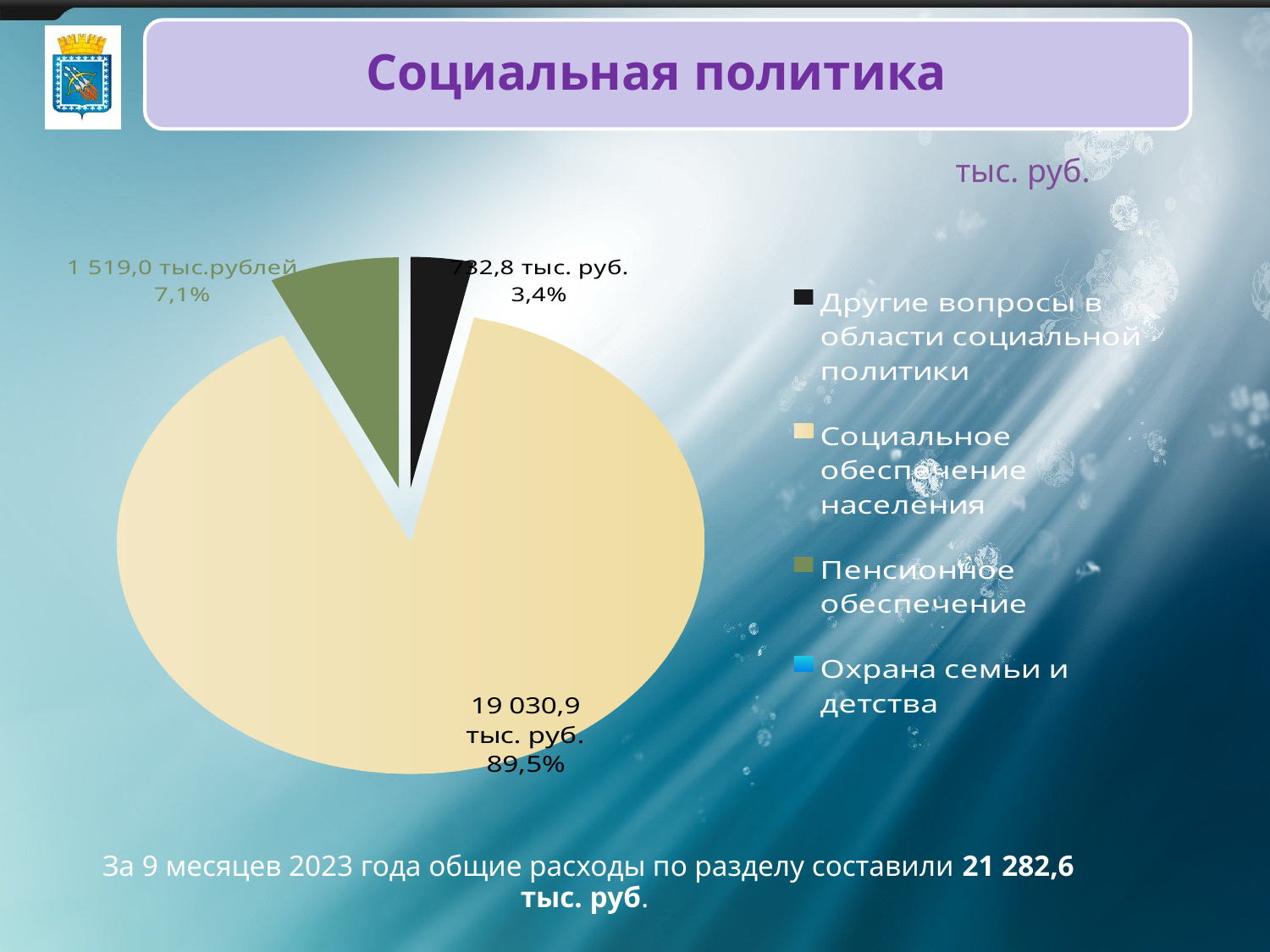
What is the title of the slide containing the pie chart? Социальная политика What share of the pie does Другие вопросы в области социальной политики take? 3,4% Which slice is larger: Пенсионное обеспечение or Другие вопросы в области социальной политики? Пенсионное обеспечение Which category has the largest slice of the pie? Социальное обеспечение населения How many entries does the legend of the pie chart list? 4 By how many percentage points does the share of Социальное обеспечение населения exceed the share of Пенсионное обеспечение? 82,4 What kind of chart is shown on the slide? pie chart What is the value shown for Пенсионное обеспечение? 1 519,0 тыс.рублей What colour represents Пенсионное обеспечение in the legend? green What share of the pie does Пенсионное обеспечение take? 7,1% What is the value shown for Социальное обеспечение населения? 19 030,9 тыс. руб. What share of the pie does Социальное обеспечение населения take? 89,5%